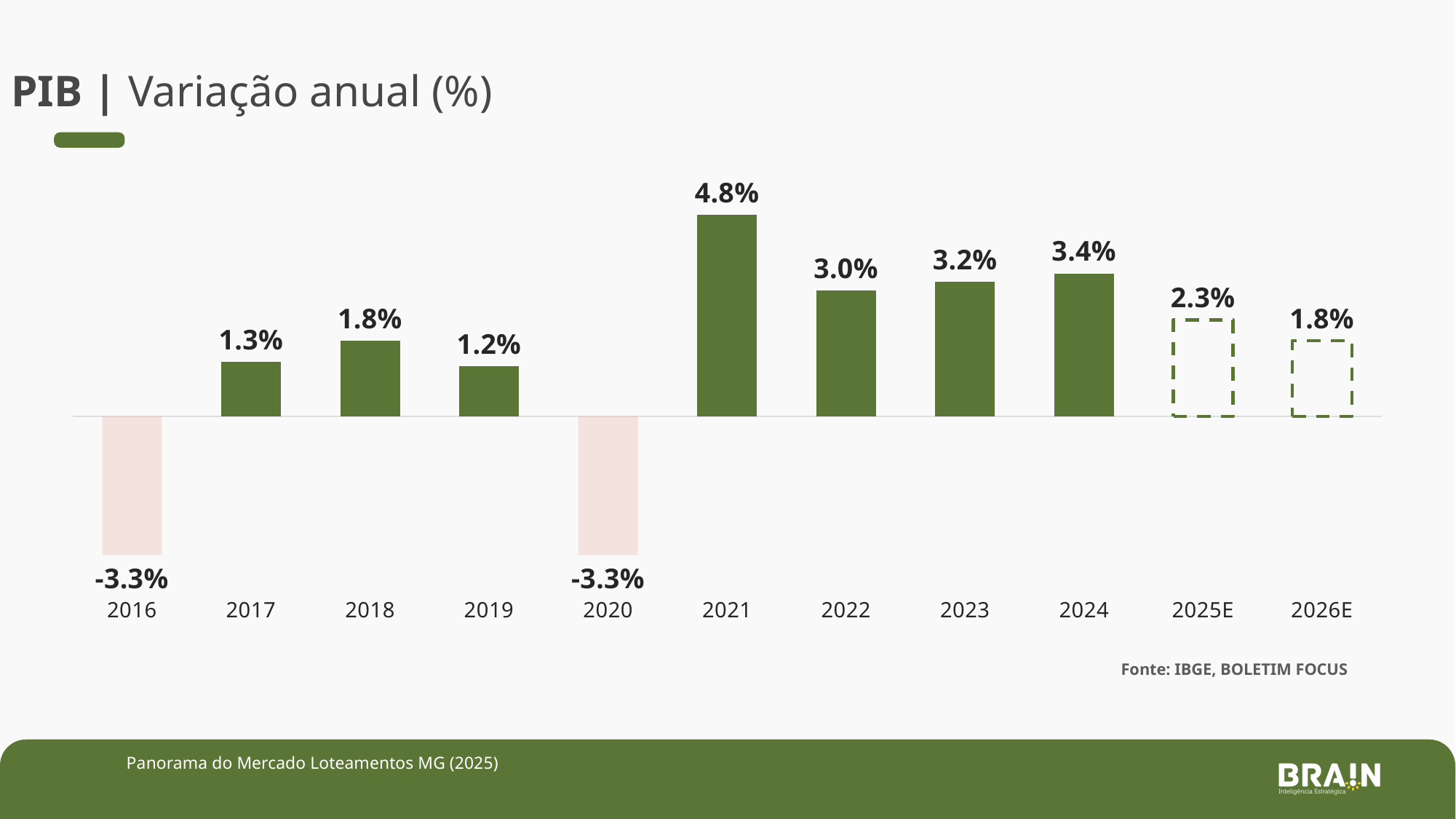
What is the title of the chart? PIB | Variação anual (%) Do the values rise or fall from 2022 to 2024? rise Which year has the highest value? 2021 What is the difference between the values for 2021 and 2022? 1.8% Which is larger, the value for 2018 or the value for 2019? 2018 What is the value for 2025E? 2.3% What is the value for 2024? 3.4% What kind of chart is shown? bar chart How many years are shown on the x axis? 11 What is the difference between the values for 2024 and 2026E? 1.6% What is the value for 2016? -3.3% What is the value for 2021? 4.8%